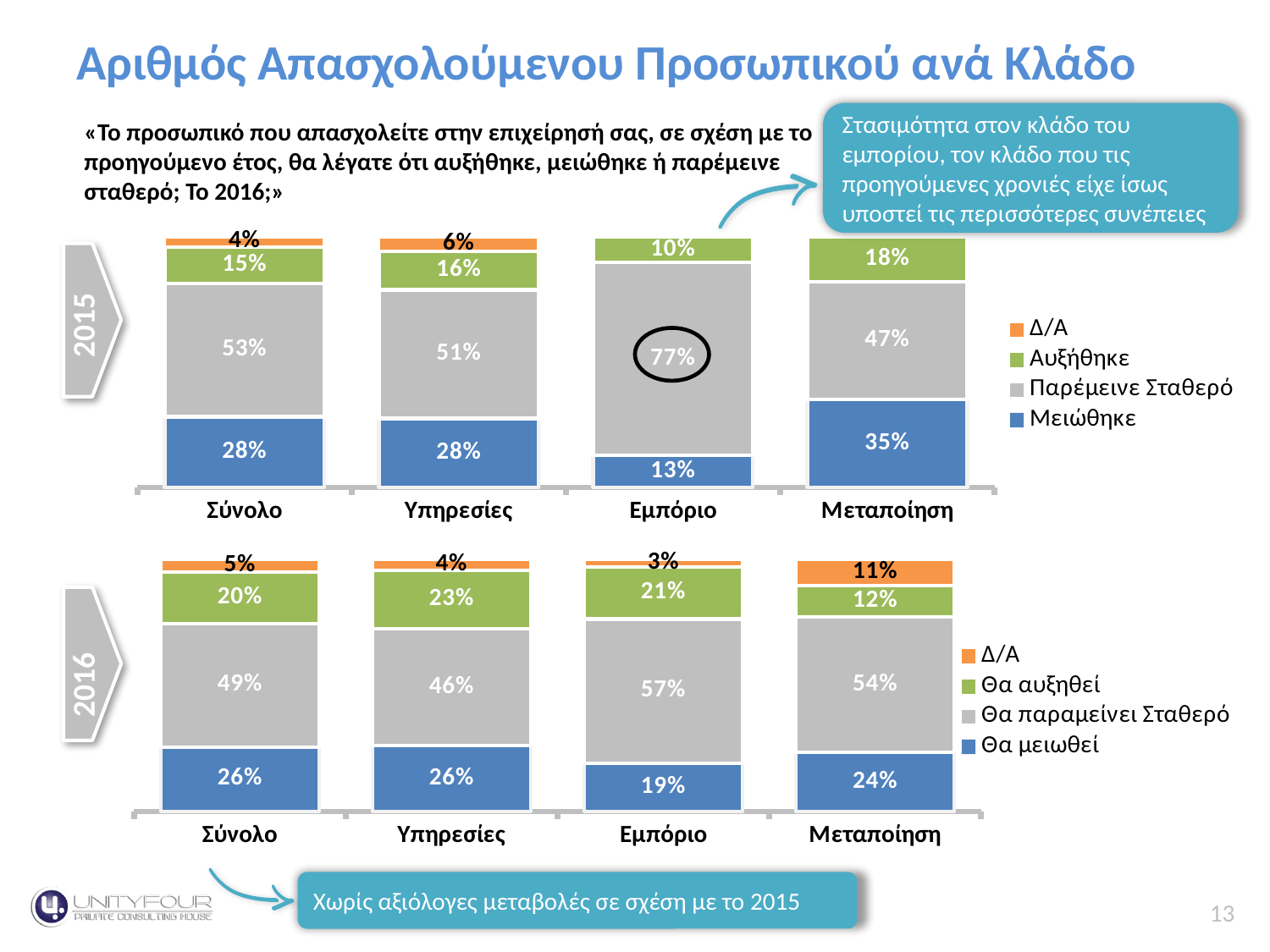
In the 2016 chart (bottom), which is larger: Θα παραμείνει Σταθερό for Εμπόριο or for Μεταποίηση? Εμπόριο How many series does the legend of the 2015 chart (top) list? 4 In the 2016 chart (bottom), which category has the lowest value for Θα μειωθεί? Εμπόριο In the 2016 chart (bottom), what is the value of Θα αυξηθεί for Υπηρεσίες? 23% In the 2015 chart (top), what is the value of Παρέμεινε Σταθερό for Εμπόριο? 77% In the 2016 chart (bottom), what is the value of Δ/Α for Μεταποίηση? 11% What type of chart is the 2015 chart (top)? Stacked bar chart In the 2015 chart (top), what is the difference between the Μειώθηκε values for Μεταποίηση and Εμπόριο? 22% In the 2015 chart (top), what is the value of Μειώθηκε for Μεταποίηση? 35% In the 2016 chart (bottom), which series is shown in orange in the legend? Δ/Α In the 2015 chart (top), which category has the highest value for Παρέμεινε Σταθερό? Εμπόριο How many categories are shown on the x axis of the 2016 chart (bottom)? 4